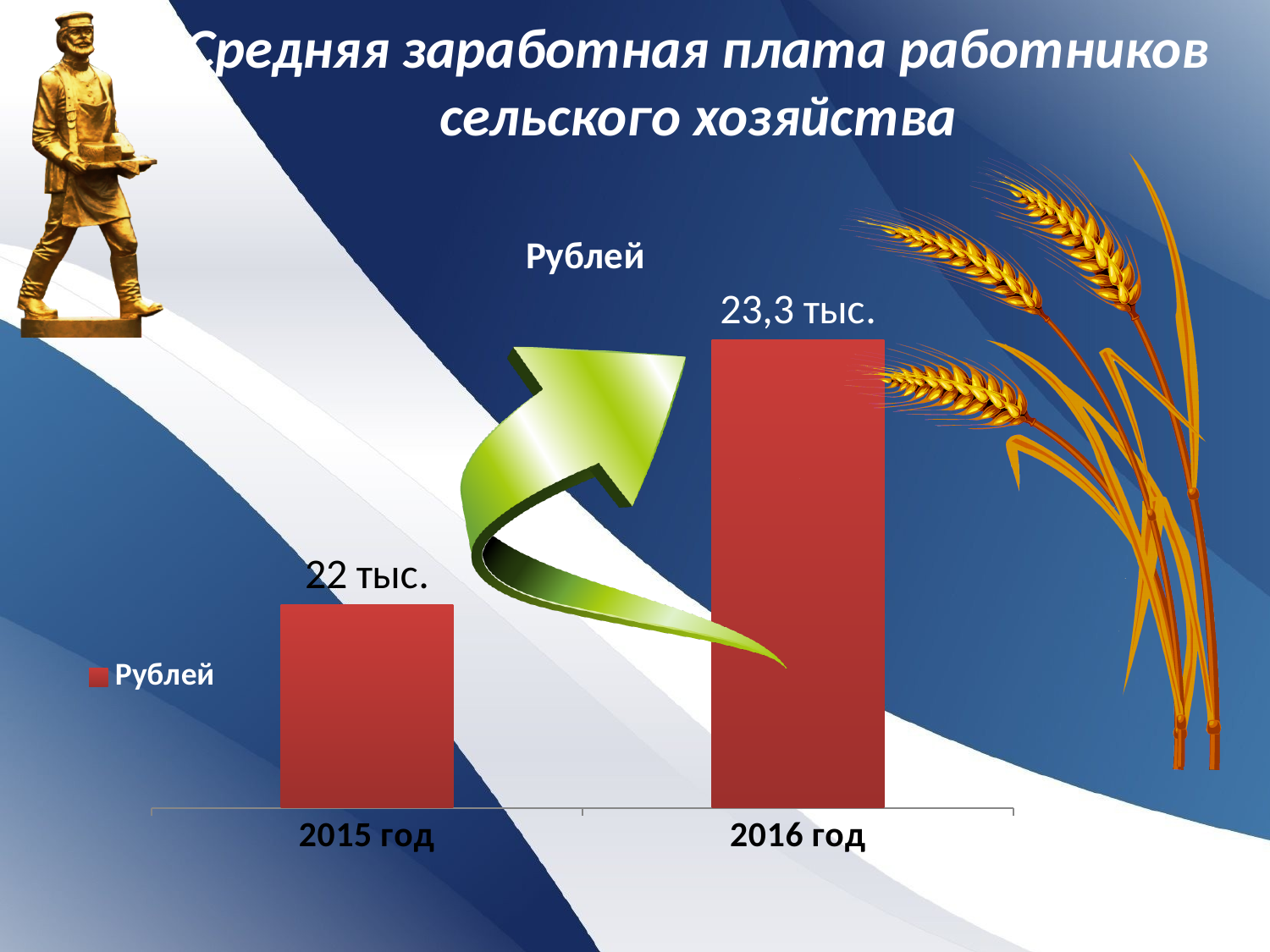
What is the value for 2016 год? 23,3 тыс. What kind of chart is shown on the slide? bar chart What is the difference between the values for 2016 год and 2015 год? 1,3 тыс. Which year has the lowest value? 2015 год How many series does the legend list? 1 Which year has the highest value? 2016 год What is the title of the slide? Средняя заработная плата работников сельского хозяйства Do the values rise or fall from 2015 год to 2016 год? rise How many categories are shown on the x axis? 2 Which is larger, the value for 2015 год or for 2016 год? 2016 год What is the value for 2015 год? 22 тыс. What is the name of the series in the legend? Рублей